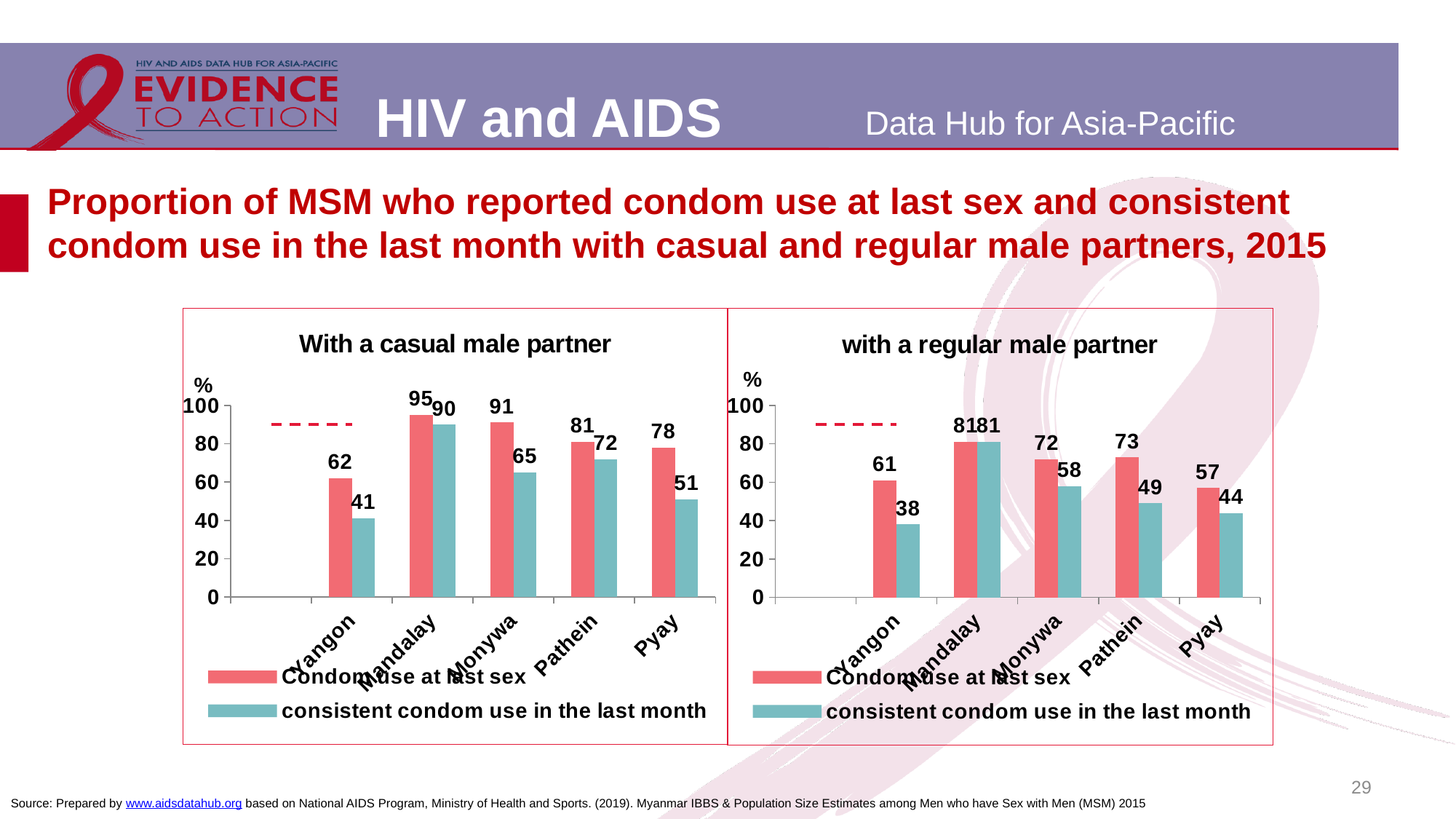
How many series does the legend of the 'with a regular male partner' chart list? 2 Is the value for condom use at last sex in Pyay higher in the 'With a casual male partner' chart or the 'with a regular male partner' chart? With a casual male partner In the 'with a regular male partner' chart, which city has the lowest value for consistent condom use in the last month? Yangon What type of chart is the 'With a casual male partner' chart? Bar chart In the 'with a regular male partner' chart, what is the value for consistent condom use in the last month in Pathein? 49 In the 'With a casual male partner' chart, what is the value for condom use at last sex in Mandalay? 95 In the 'With a casual male partner' chart, what is the difference between condom use at last sex and consistent condom use in the last month for Monywa? 26 In the 'With a casual male partner' chart, what is the value for consistent condom use in the last month in Yangon? 41 How many cities are shown on the x axis of the 'With a casual male partner' chart? 5 In the 'with a regular male partner' chart, what is the value for condom use at last sex in Pyay? 57 In the 'With a casual male partner' chart, which city has the highest value for condom use at last sex? Mandalay In the 'with a regular male partner' chart, what is the difference between condom use at last sex and consistent condom use in the last month for Yangon? 23